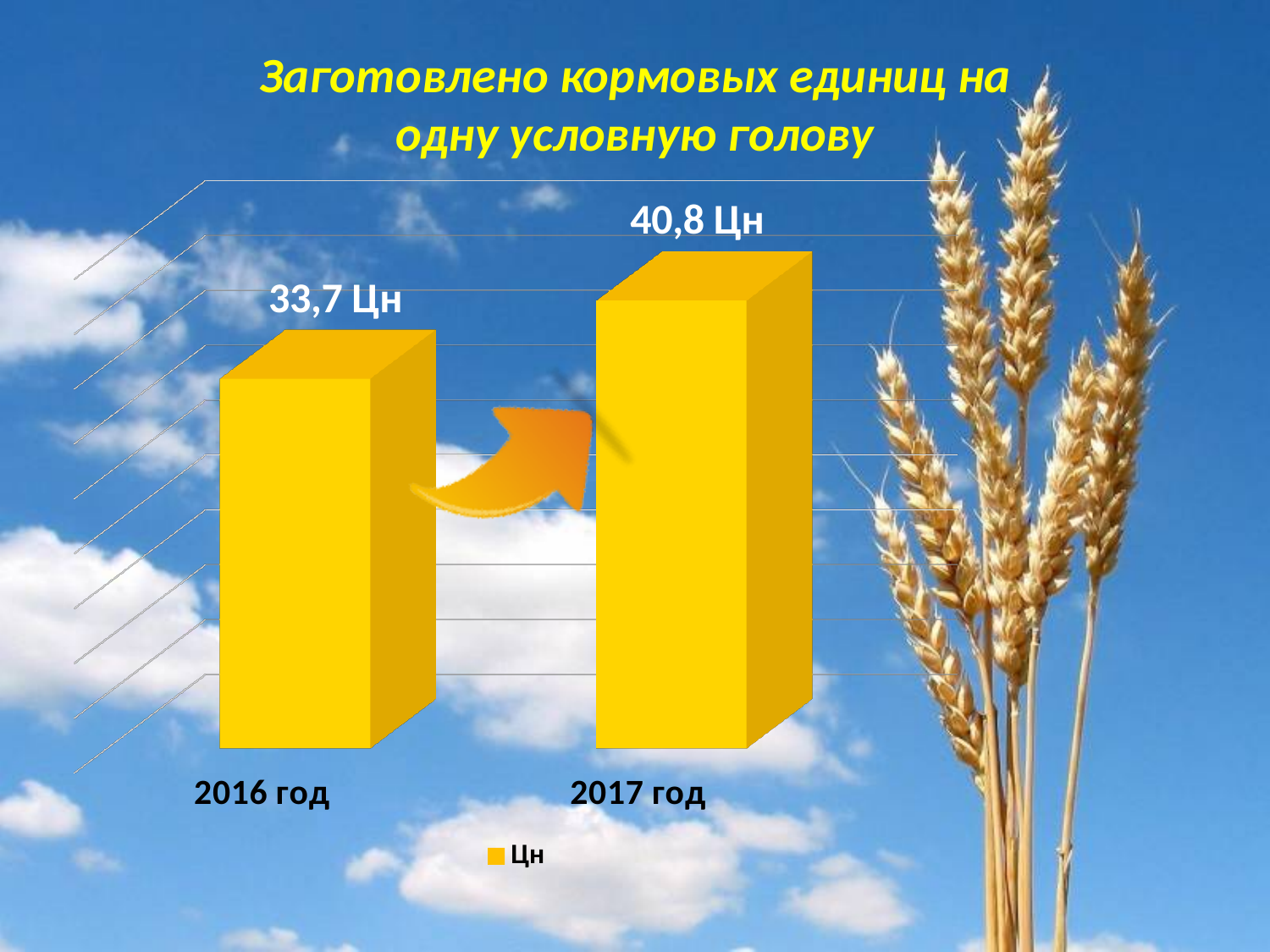
What is the name of the series in the legend? Цн By how much did the value increase from 2016 год to 2017 год? 7,1 Цн How many categories (years) are shown on the chart? 2 Is the value for 2017 год larger or smaller than the value for 2016 год? larger What is the title of the chart? Заготовлено кормовых единиц на одну условную голову What kind of chart is shown on the slide? bar chart Which year has the higher value? 2017 год Which year has the lower value? 2016 год Do the values rise or fall from 2016 год to 2017 год? rise How many series does the legend list? 1 What is the value for 2016 год? 33,7 Цн What is the value for 2017 год? 40,8 Цн